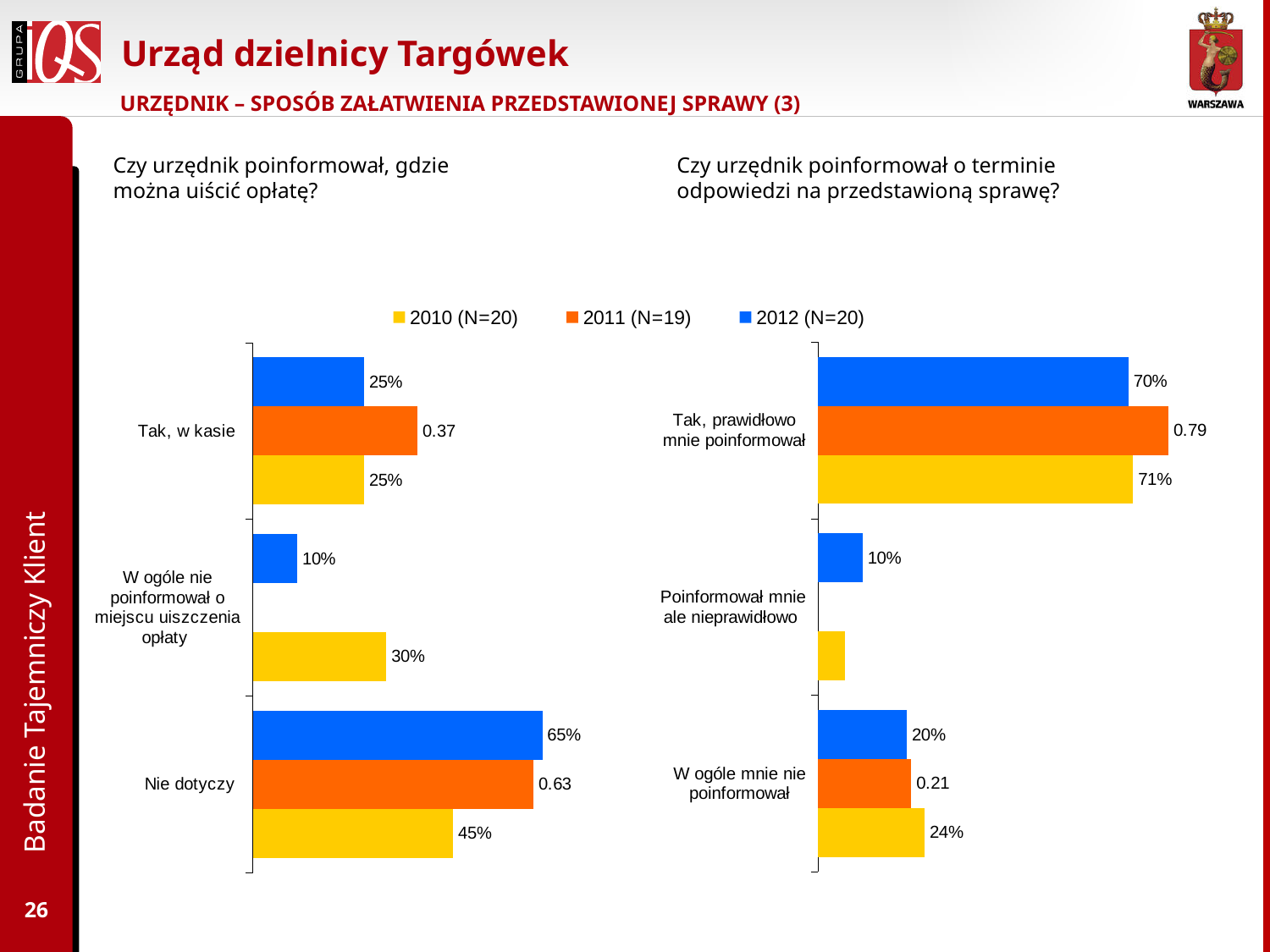
How many categories are shown in the left chart (Czy urzędnik poinformował, gdzie można uiścić opłatę?)? 3 In the right chart (Czy urzędnik poinformował o terminie odpowiedzi na przedstawioną sprawę?), what is the 2011 (N=19) value for 'Tak, prawidłowo mnie poinformował'? 0.79 In the right chart (Czy urzędnik poinformował o terminie odpowiedzi na przedstawioną sprawę?), which category has the highest 2012 (N=20) value? Tak, prawidłowo mnie poinformował In the left chart (Czy urzędnik poinformował, gdzie można uiścić opłatę?), what is the difference between the 2012 (N=20) and 2010 (N=20) values for 'Nie dotyczy'? 20% In the left chart (Czy urzędnik poinformował, gdzie można uiścić opłatę?), what is the 2010 (N=20) value for 'W ogóle nie poinformował o miejscu uiszczenia opłaty'? 30% In the right chart (Czy urzędnik poinformował o terminie odpowiedzi na przedstawioną sprawę?), what is the 2010 (N=20) value for 'W ogóle mnie nie poinformował'? 24% In the left chart (Czy urzędnik poinformował, gdzie można uiścić opłatę?), which category has the lowest 2012 (N=20) value? W ogóle nie poinformował o miejscu uiszczenia opłaty How many series does the legend list? 3 In the right chart (Czy urzędnik poinformował o terminie odpowiedzi na przedstawioną sprawę?), which is larger for 'W ogóle mnie nie poinformował': the 2012 (N=20) value or the 2010 (N=20) value? 2010 (N=20) In the left chart (Czy urzędnik poinformował, gdzie można uiścić opłatę?), what is the 2012 (N=20) value for 'Nie dotyczy'? 65% What type of chart is used on this slide? Bar chart In the left chart (Czy urzędnik poinformował, gdzie można uiścić opłatę?), what is the 2011 (N=19) value for 'Tak, w kasie'? 0.37